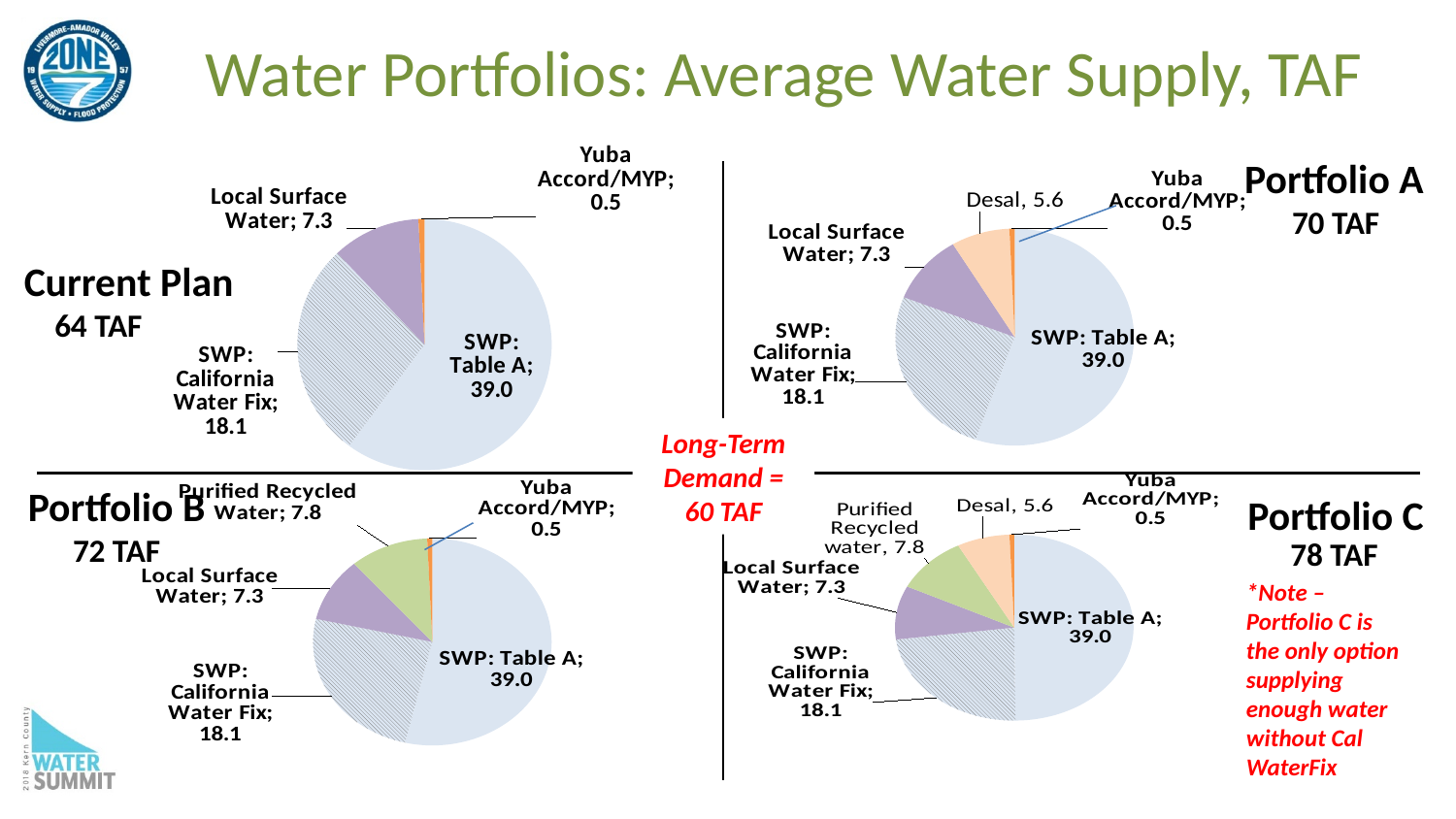
What kind of charts are shown on the slide? Pie charts In the Portfolio C pie chart, which is larger: Local Surface Water or Desal? Local Surface Water In the Portfolio B pie chart, what is the value for Purified Recycled Water? 7.8 In the Portfolio A pie chart, what is the value for Desal? 5.6 In the Current Plan pie chart, which category has the largest value? SWP: Table A What total average water supply is stated for Portfolio C? 78 TAF In the Portfolio C pie chart, which category has the smallest value? Yuba Accord/MYP How many slices does the Portfolio C pie chart have? 6 In the Portfolio C pie chart, what is the value for SWP: California Water Fix? 18.1 How many slices does the Current Plan pie chart have? 4 In the Current Plan pie chart, what is the value for SWP: Table A? 39.0 In the Portfolio A pie chart, what is the difference between SWP: Table A and SWP: California Water Fix? 20.9